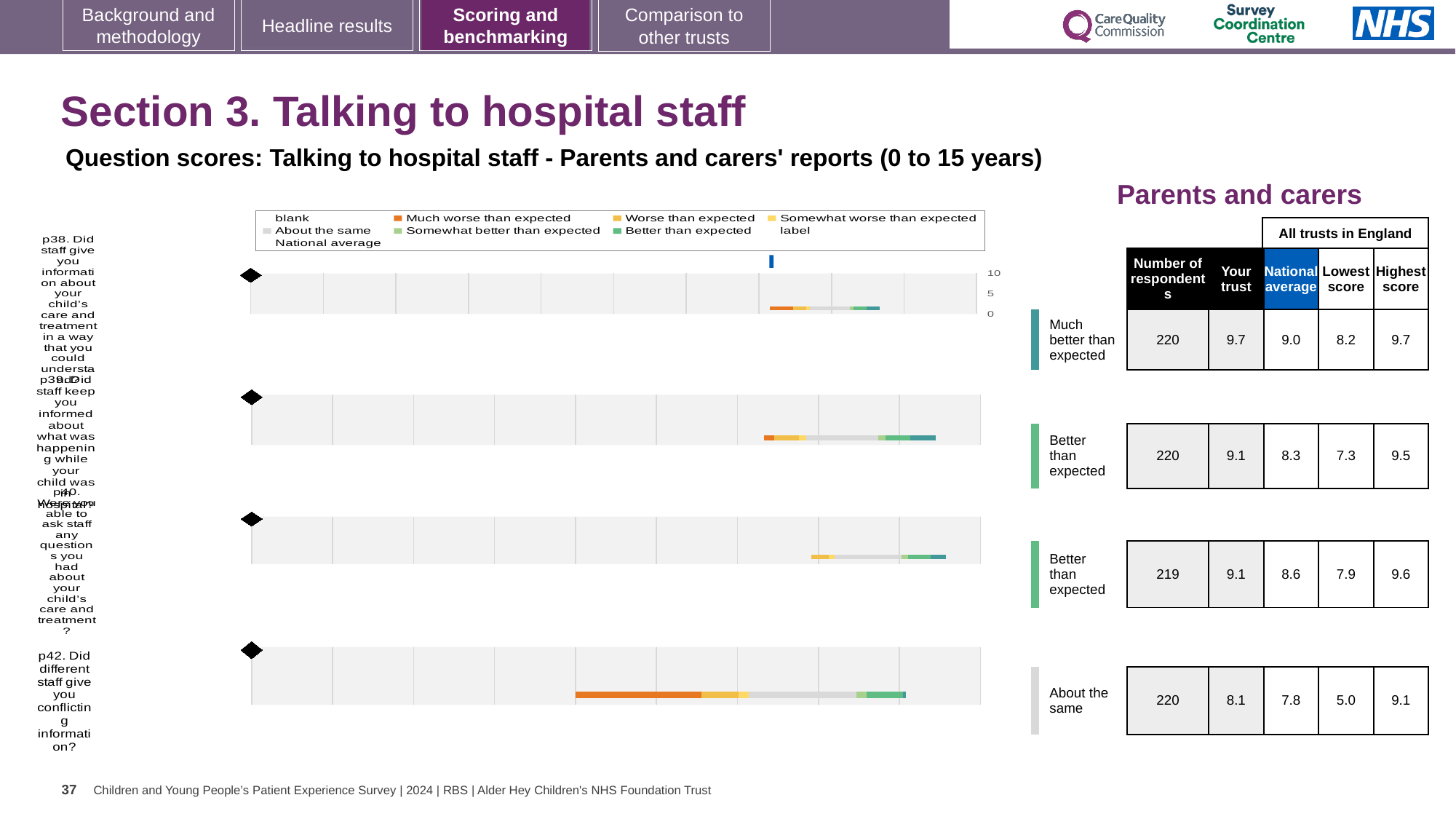
Which of the four question charts has the lowest 'Your trust' score in the table? p42 What kind of chart is used to show the question scores for p38 to p42? bar chart For the p38 chart (staff giving information about your child's care and treatment), what is the 'Your trust' score in the table? 9.7 Which legend entry is shown in dark teal/green? Better than expected For the p42 chart (different staff giving conflicting information), what is the 'Lowest score' in the table? 5.0 For the p40 chart (able to ask staff any questions), how many respondents are listed? 219 What is the difference between the 'Your trust' score and the National average for the p38 chart? 0.7 How many question charts (p38, p39, p40, p42) are shown on the slide? 4 In the legend, what colour represents 'Much worse than expected'? orange For the p39 chart (staff keeping you informed), what is the National average score? 8.3 How many entries does the legend above the charts list? 9 Which benchmark category is shown next to the p42 chart? About the same